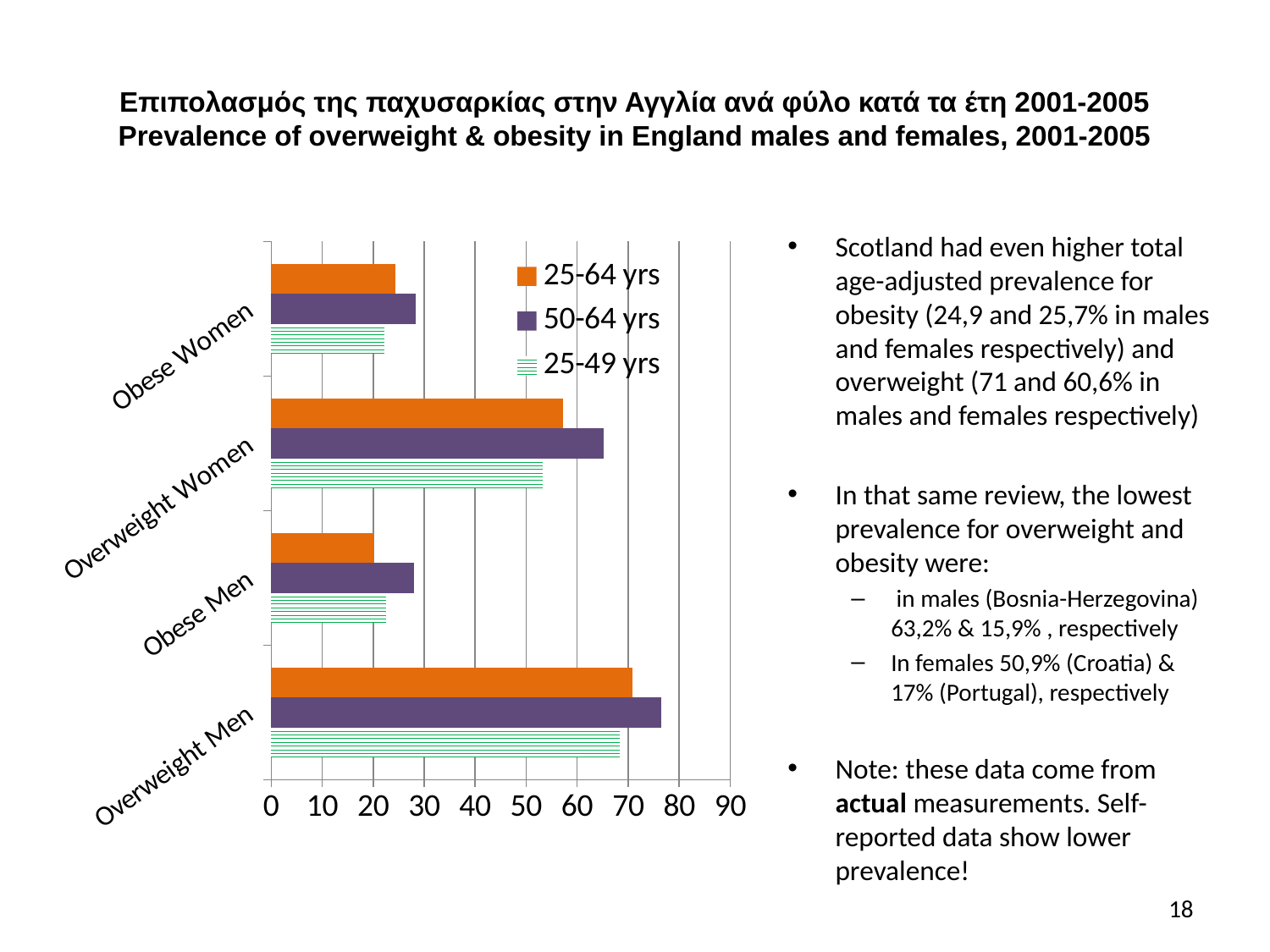
How many categories are shown on the chart's vertical axis? 4 Which category has the lowest value for the 25-64 yrs series? Obese Men Which category has the highest value for the 25-49 yrs series? Overweight Men Is the 50-64 yrs value for Overweight Men greater or less than 70? greater Which age group is shown in orange in the chart legend? 25-64 yrs What type of chart is shown on the slide? bar chart Which category has the highest value for the 50-64 yrs series? Overweight Men Which is larger: the 25-64 yrs value for Overweight Men or the 25-64 yrs value for Overweight Women? Overweight Men Is the 25-64 yrs value for Obese Men greater or less than 30? less Is the 50-64 yrs value for Overweight Women greater or less than 60? greater How many series does the chart legend list? 3 For Overweight Women, which series has the larger value: 50-64 yrs or 25-49 yrs? 50-64 yrs